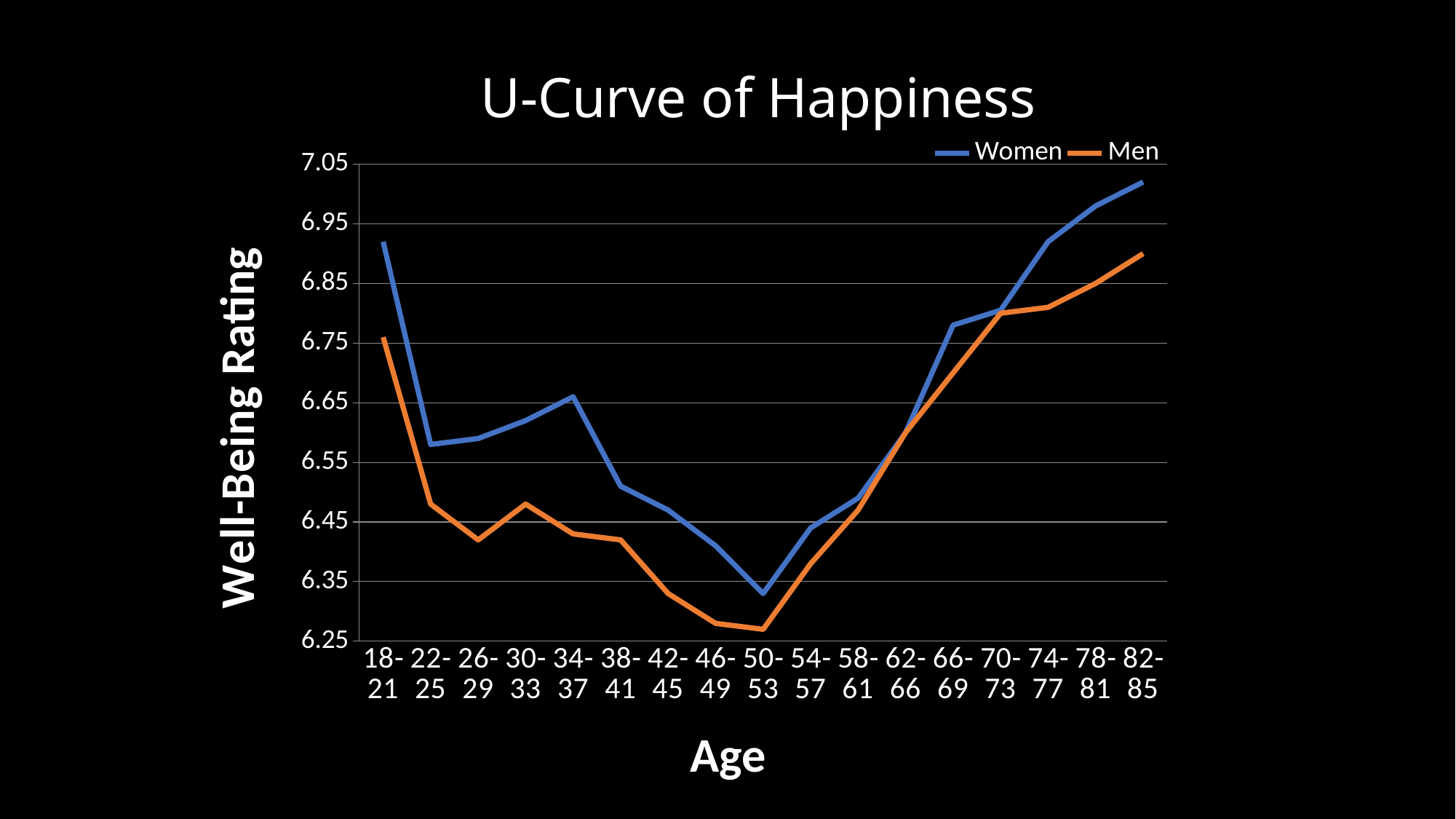
Which age group has the lowest well-being rating for Men? 50-53 What kind of chart is shown on the slide? line chart Is the well-being rating for Men at age 46-49 greater or less than 6.35? less How many series does the legend list? 2 What is the title of the chart? U-Curve of Happiness Which age group has the lowest well-being rating for Women? 50-53 Which age group has the highest well-being rating for Women? 82-85 At age 18-21, which series has the higher well-being rating, Women or Men? Women Which age group has the highest well-being rating for Men? 82-85 Do the well-being ratings for Women rise or fall from age 50-53 to age 82-85? rise Is the well-being rating for Women at age 82-85 greater or less than 6.95? greater How many age groups are shown on the x axis? 17